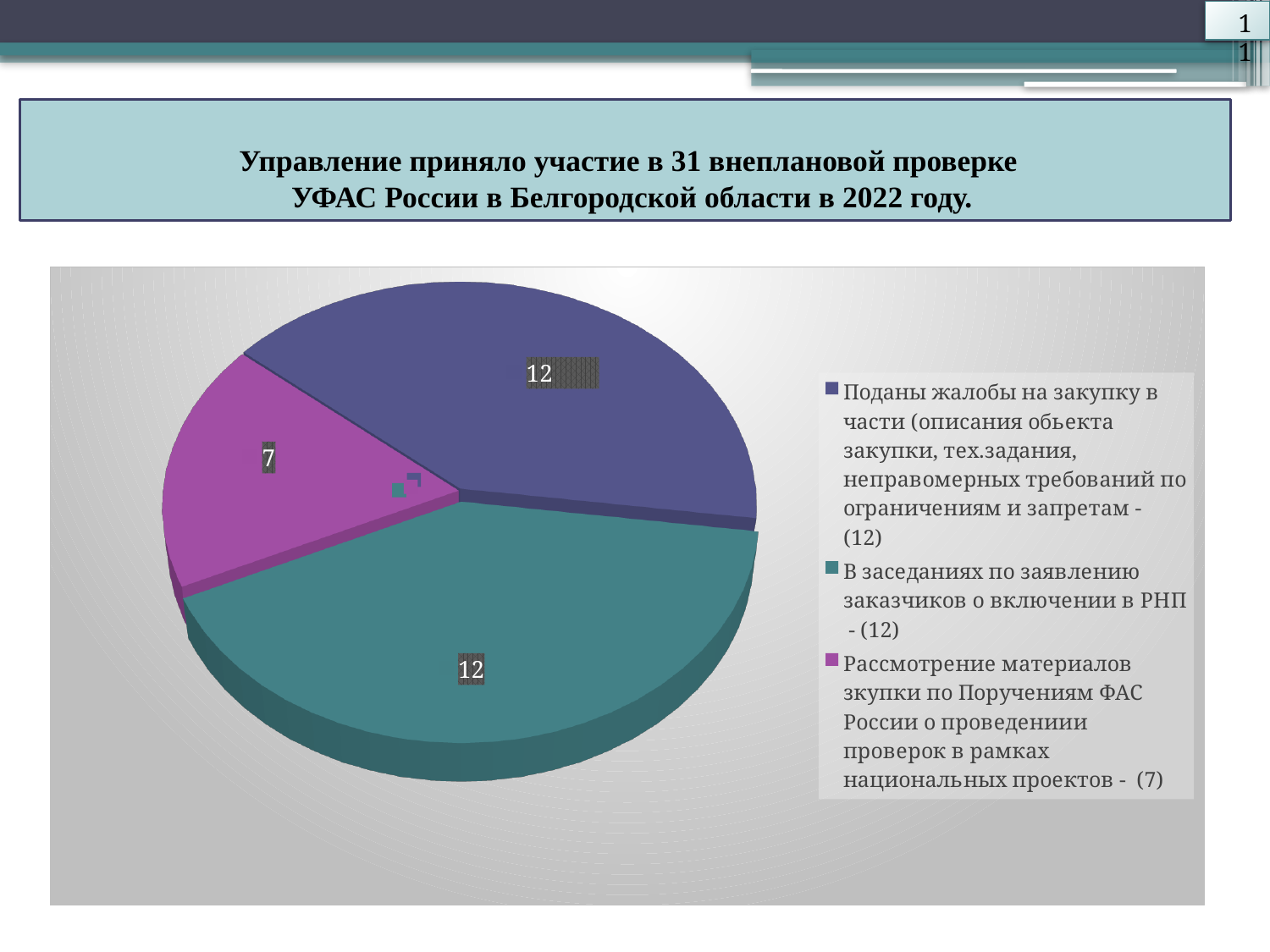
Which category has the smallest slice in the pie chart? Рассмотрение материалов зкупки по Поручениям ФАС России о проведениии проверок в рамках национальных проектов According to the slide title, in how many unscheduled inspections did the Administration take part in 2022? 31 How many entries does the legend of the pie chart list? 3 What is the total of all slices in the pie chart? 31 Which is larger: the slice for "Поданы жалобы на закупку" or the slice for "Рассмотрение материалов зкупки по Поручениям ФАС России"? Поданы жалобы на закупку How many slices does the pie chart have? 3 What is the value of the slice for "В заседаниях по заявлению заказчиков о включении в РНП"? 12 What is the value of the slice for "Рассмотрение материалов зкупки по Поручениям ФАС России о проведениии проверок в рамках национальных проектов"? 7 What type of chart is shown on the slide? Pie chart What is the difference between the slice for "В заседаниях по заявлению заказчиков о включении в РНП" and the slice for "Рассмотрение материалов зкупки по Поручениям ФАС России"? 5 What colour is the slice for "В заседаниях по заявлению заказчиков о включении в РНП"? Teal What is the value of the slice for "Поданы жалобы на закупку в части (описания обьекта закупки, тех.задания, неправомерных требований по ограничениям и запретам"? 12